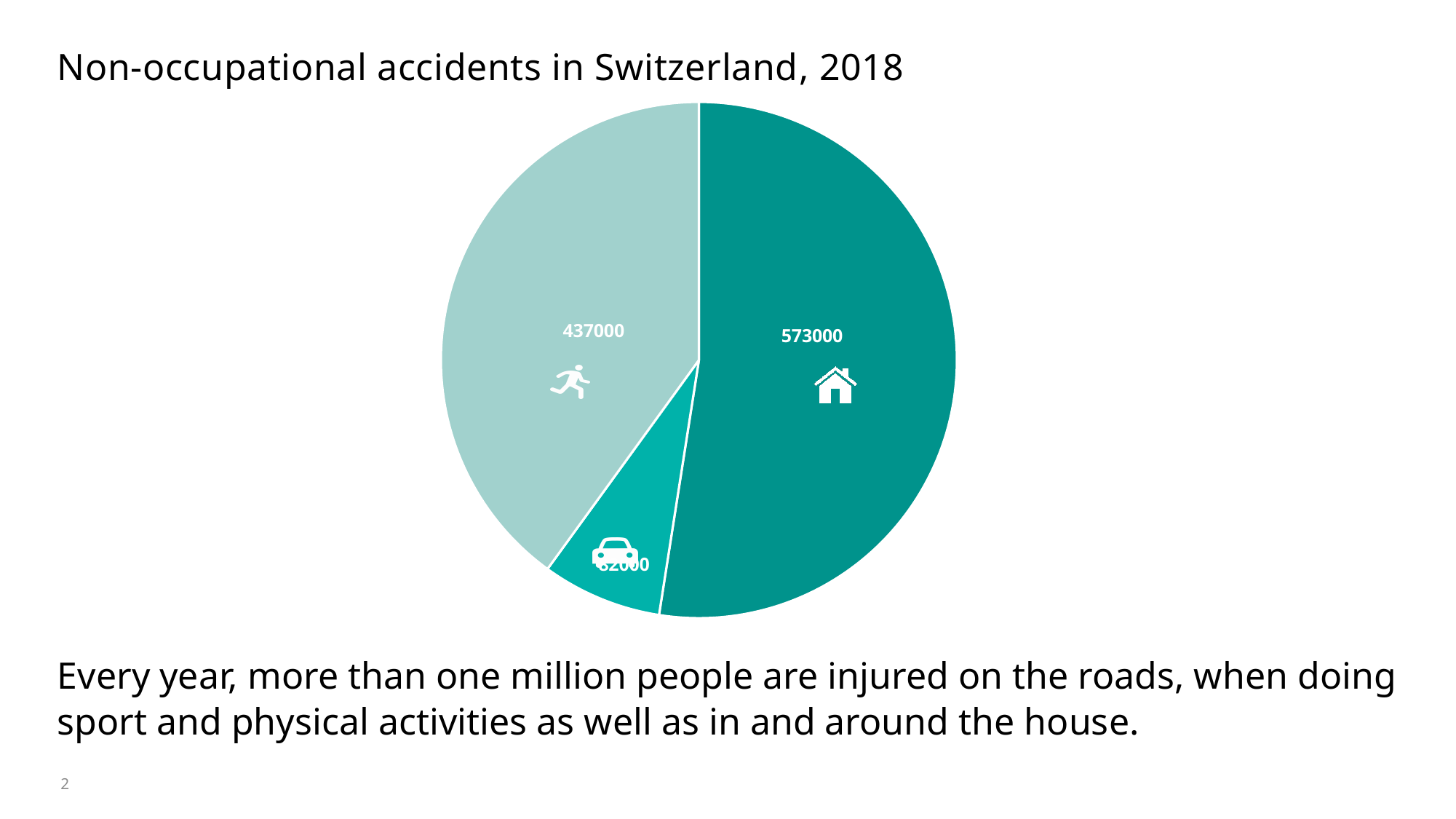
What is the difference between the value of the house icon slice and the running figure icon slice? 136000 Which is larger, the slice with the house icon or the slice with the running figure icon? the slice with the house icon Which slice of the pie chart is drawn in the lightest colour? the slice with the running figure icon How many slices does the pie chart have? 3 What is the value of the slice marked with the house icon? 573000 What kind of chart is shown on the slide? pie chart What is the title of the slide containing the pie chart? Non-occupational accidents in Switzerland, 2018 What is the value of the slice marked with the running figure icon? 437000 Which slice of the pie chart is the smallest? the slice with the car icon Which slice of the pie chart is the largest? the slice with the house icon Which is larger, the slice with the running figure icon or the slice with the car icon? the slice with the running figure icon